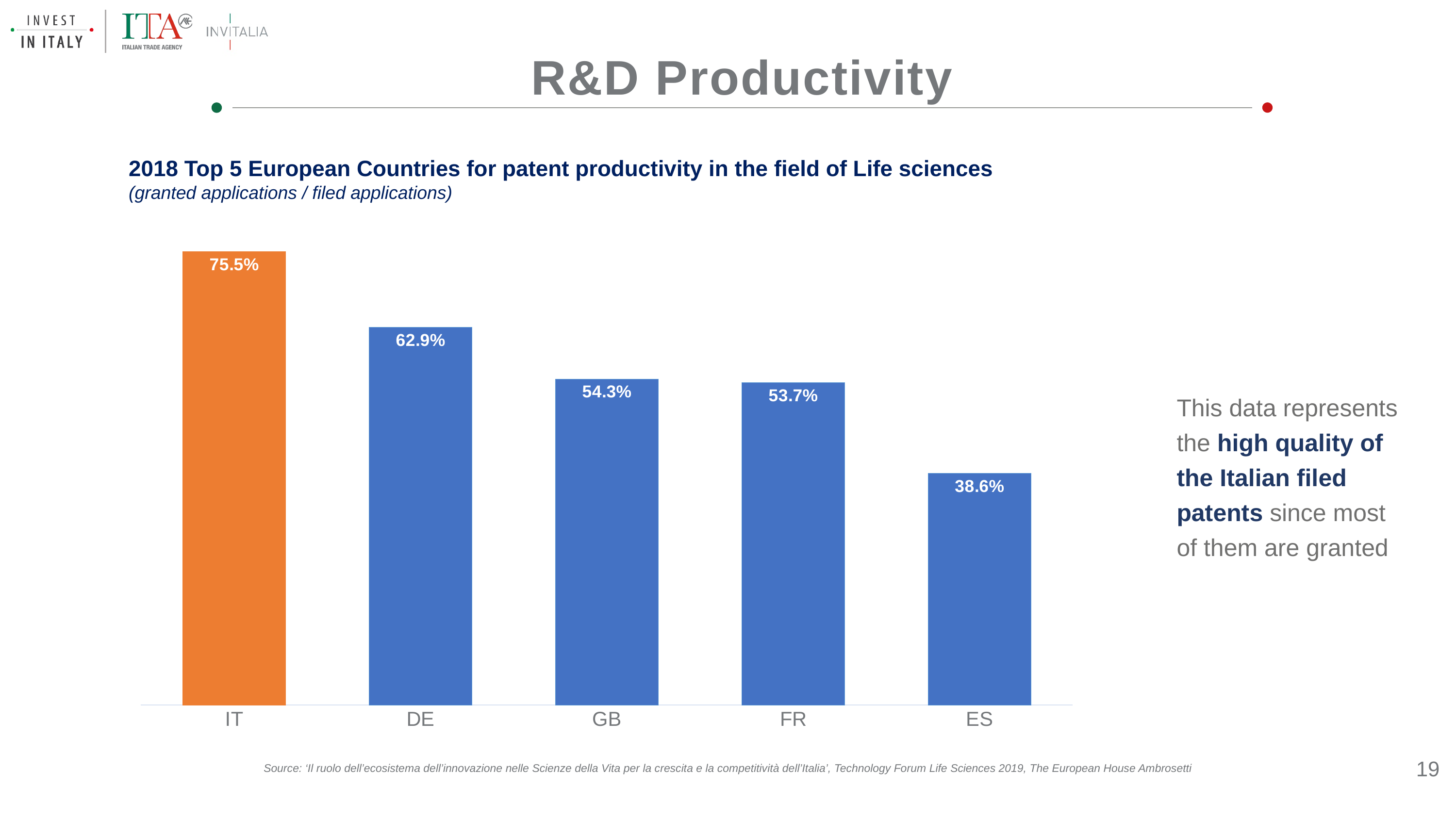
Which country's bar is coloured orange? IT What is the patent productivity value for DE? 62.9% Which country has the highest patent productivity? IT What is the patent productivity value for ES? 38.6% What is the difference between the values for GB and FR? 0.6% What is the patent productivity value for IT? 75.5% Which has a higher value, DE or GB? DE How many countries are shown in the chart? 5 Do the values rise or fall from left to right across the countries? Fall What type of chart is shown on the slide? Bar chart Which country has the lowest patent productivity? ES What is the difference between the values for IT and DE? 12.6%